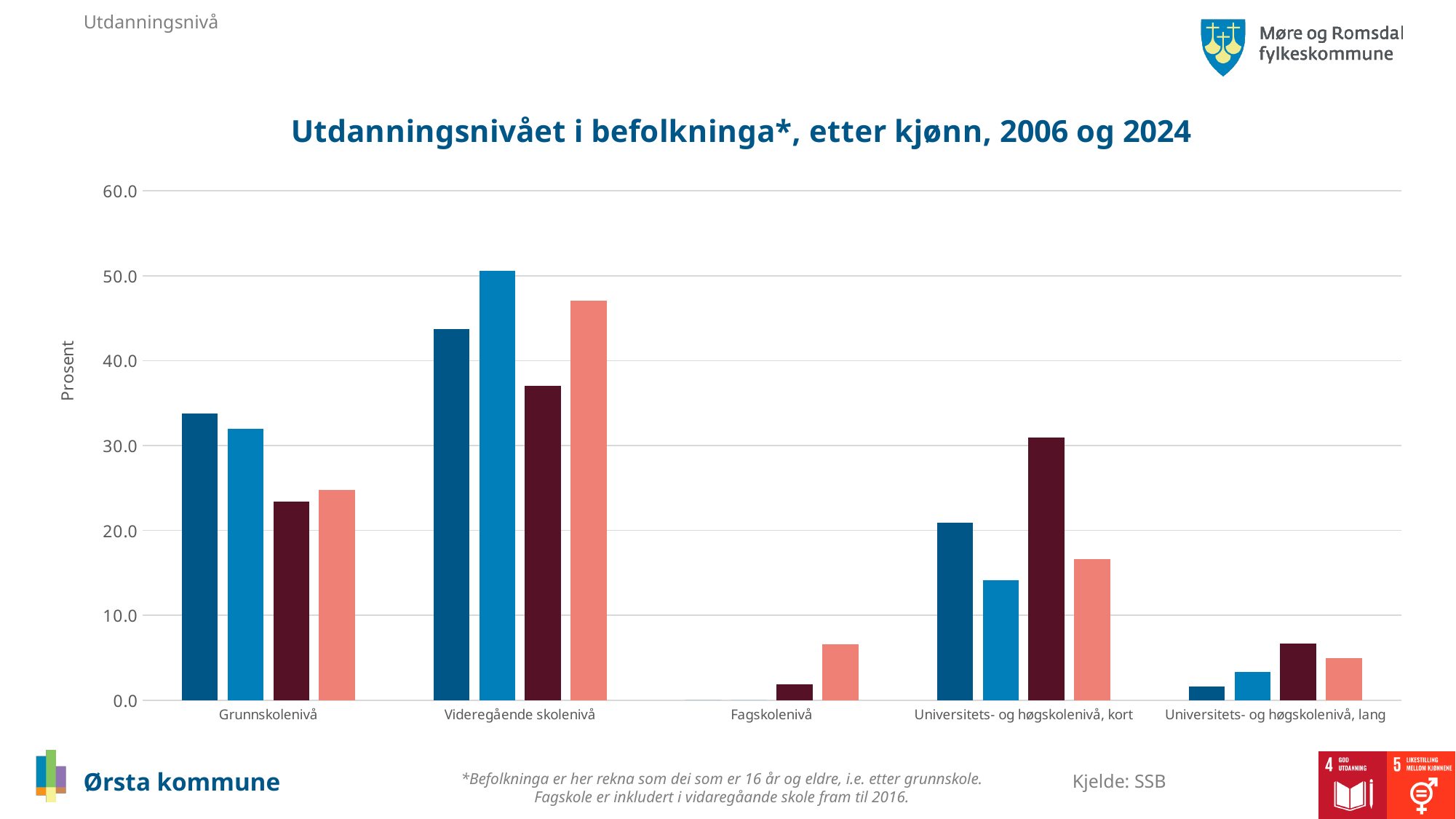
Is the tallest bar for Universitets- og høgskolenivå, lang greater or less than 10? less Is the tallest bar for Fagskolenivå greater or less than 10? less How many education-level categories are shown on the x axis? 5 Which category has the lowest bars overall? Fagskolenivå Which category contains the tallest bar in the chart? Videregående skolenivå What is the label on the y axis? Prosent Is the tallest bar for Universitets- og høgskolenivå, kort greater or less than 20? greater What kind of chart is shown on the slide? bar chart What is the title of the chart? Utdanningsnivået i befolkninga*, etter kjønn, 2006 og 2024 Which category has the taller tallest bar: Grunnskolenivå or Universitets- og høgskolenivå, kort? Grunnskolenivå